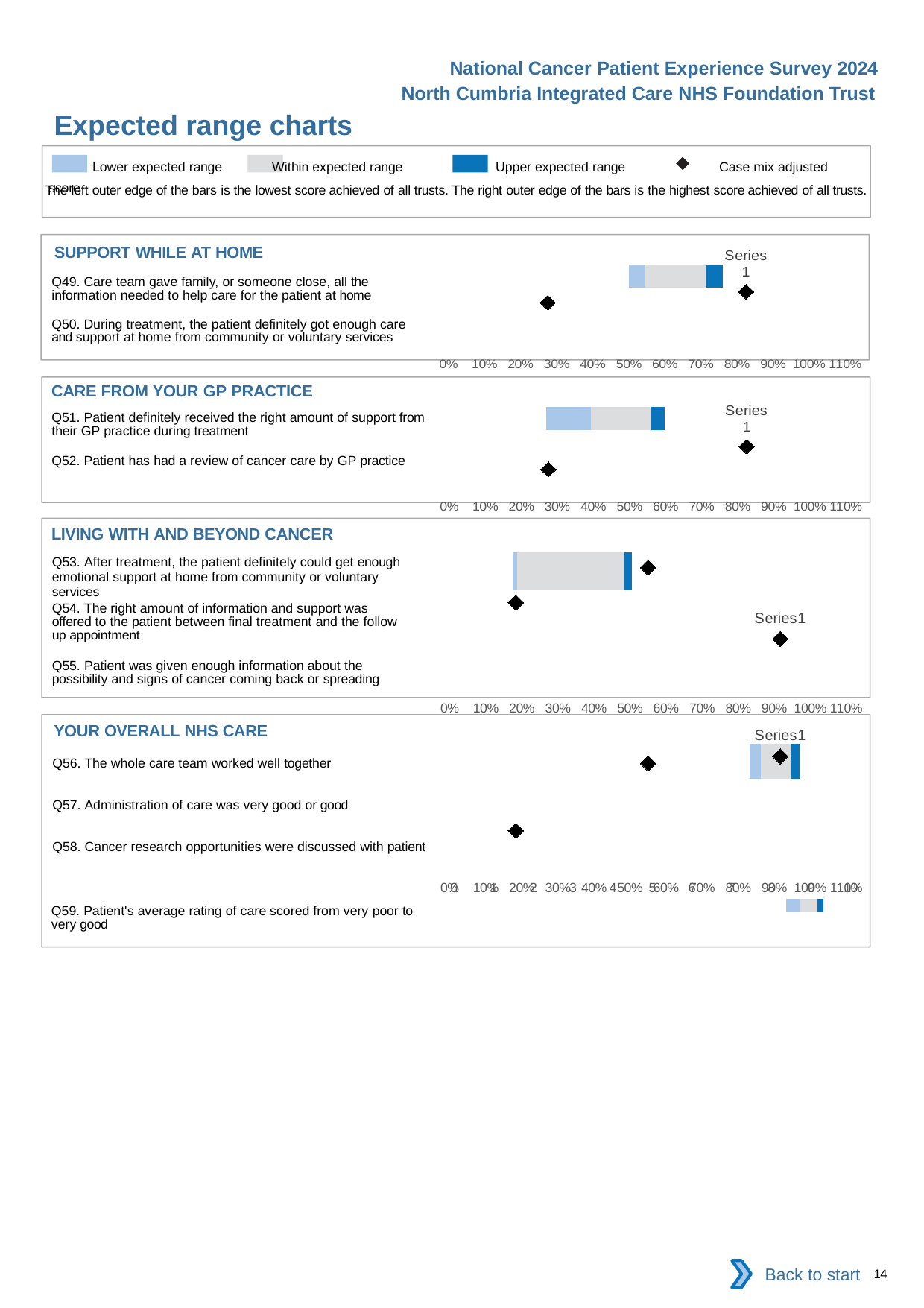
How many questions are listed in the CARE FROM YOUR GP PRACTICE chart? 2 Which legend entry is represented by a diamond marker? Case mix adjusted score In the CARE FROM YOUR GP PRACTICE chart, is the left edge of the expected range bar greater or less than 10%? greater In the LIVING WITH AND BEYOND CANCER chart, is the right edge of the expected range bar greater or less than 80%? less How many questions are listed in the LIVING WITH AND BEYOND CANCER chart? 3 What kind of chart is used in the Expected range charts on this slide? bar chart How many questions are listed in the YOUR OVERALL NHS CARE chart? 4 What is the highest value shown on the x axis of the SUPPORT WHILE AT HOME chart? 110% What is the title of the slide's charts? Expected range charts In the SUPPORT WHILE AT HOME chart, is the right edge of the expected range bar greater or less than 40%? greater How many entries does the legend at the top of the slide list? 4